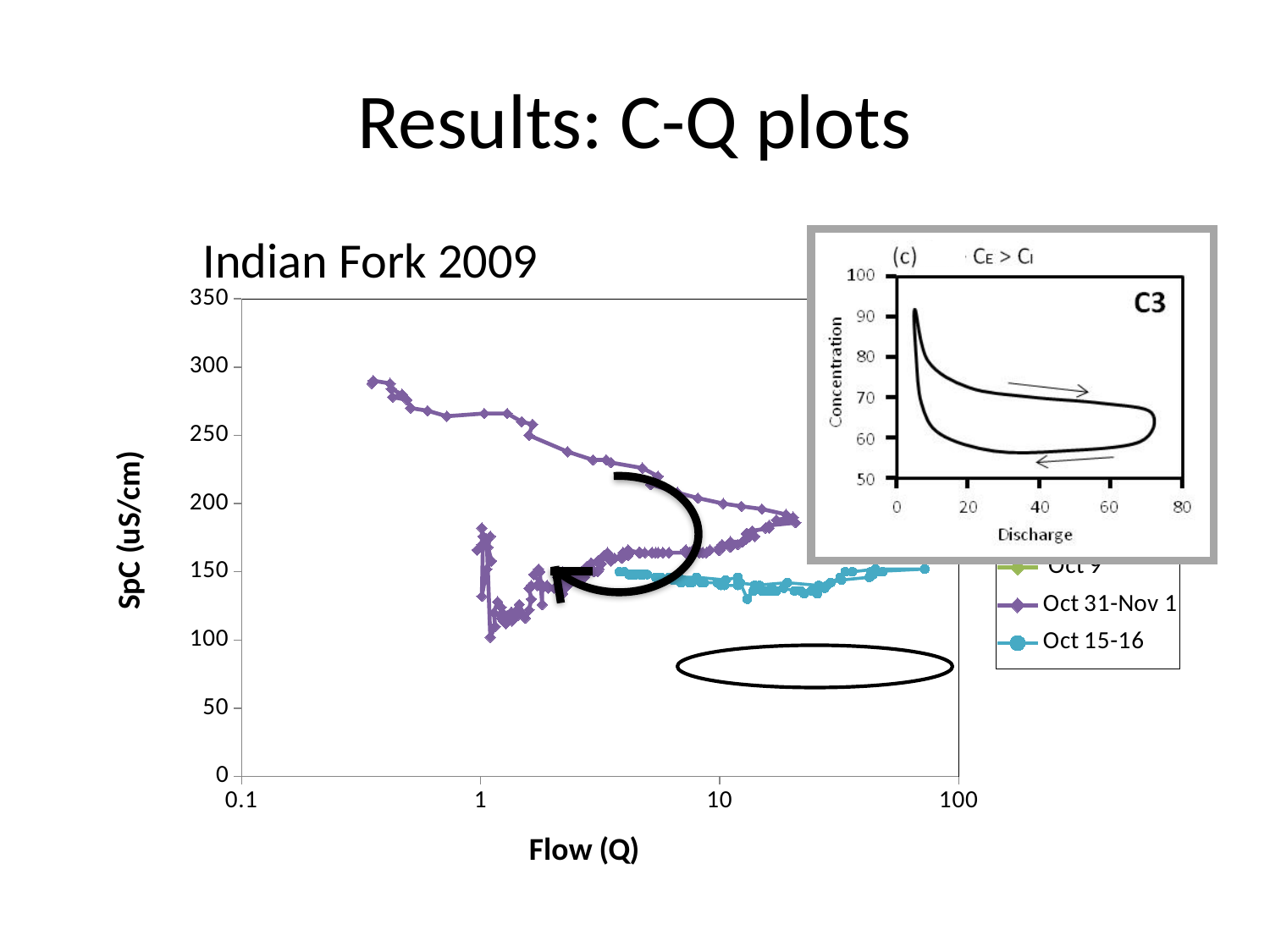
On the Indian Fork 2009 chart, along the upper branch of the Oct 31-Nov 1 series, does SpC rise or fall as flow increases from about 0.4 to 20? fall On the inset chart labelled C3, what is the label of the x axis? Discharge On the inset chart labelled C3, what is the maximum value shown on the x axis? 80 On the Indian Fork 2009 chart, what is the label of the x axis? Flow (Q) On the Indian Fork 2009 chart, which series reaches the highest SpC value, Oct 31-Nov 1 or Oct 15-16? Oct 31-Nov 1 On the Indian Fork 2009 chart, is the highest SpC value of the Oct 31-Nov 1 series greater or less than 250? greater On the Indian Fork 2009 chart, is the lowest SpC value of the Oct 31-Nov 1 series greater or less than 150? less What kind of chart is the Indian Fork 2009 chart? line chart On the Indian Fork 2009 chart, are the SpC values of the Oct 15-16 series greater or less than 200? less